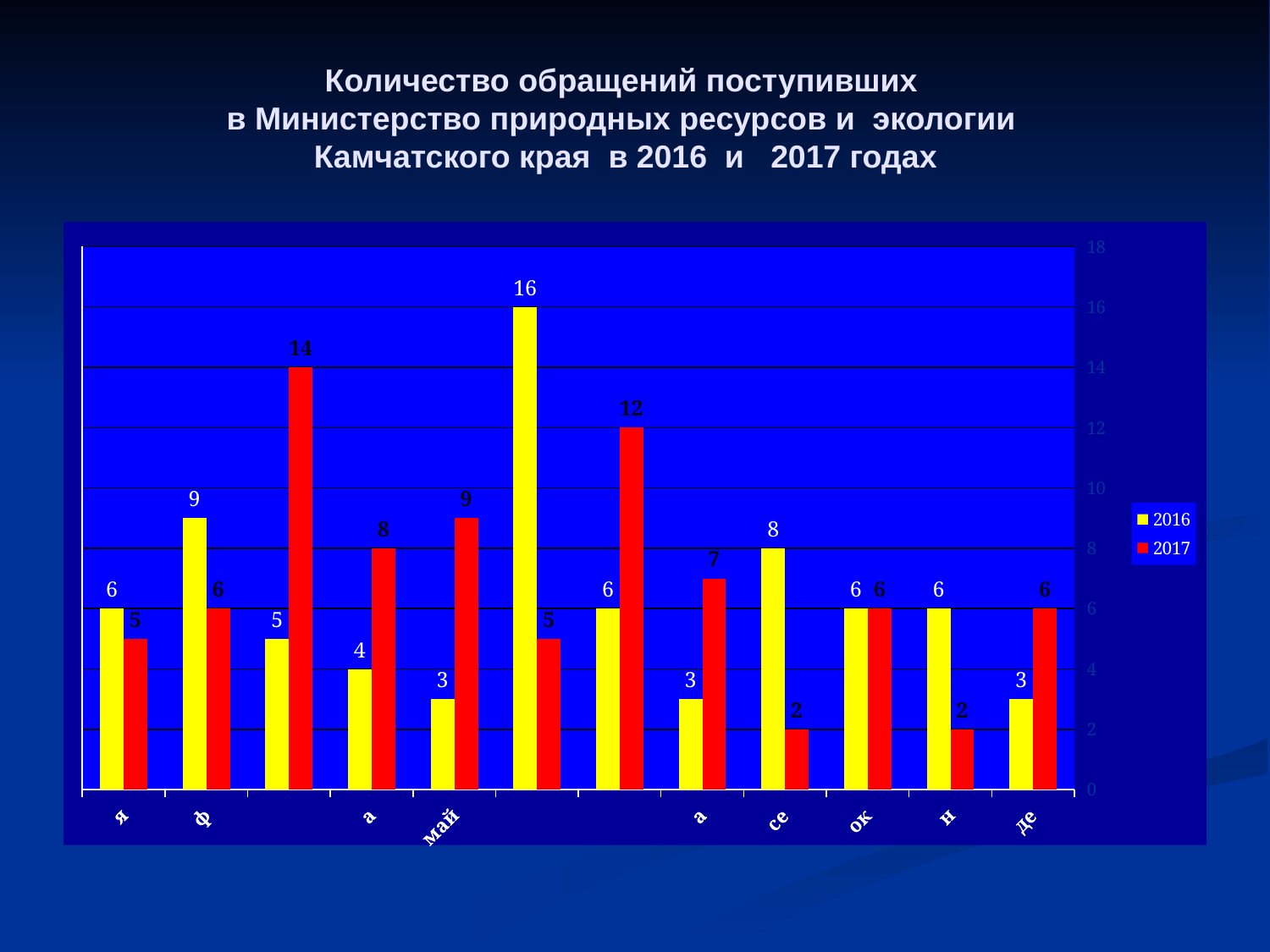
How many series does the legend list? 2 What is the value for 2016 in the category labelled "ок"? 6 Which colour represents the 2016 series? yellow What is the value for 2017 in the category labelled "се"? 2 What kind of chart is shown on the slide? bar chart What is the highest value in the 2017 series? 14 What is the highest value in the 2016 series? 16 What is the value for 2016 in the category labelled "май"? 3 In the category labelled "май", how much larger is the 2017 value than the 2016 value? 6 In the category labelled "се", which series has the larger value, 2016 or 2017? 2016 What is the value for 2017 in the category labelled "май"? 9 How many categories (months) are plotted along the x axis? 12